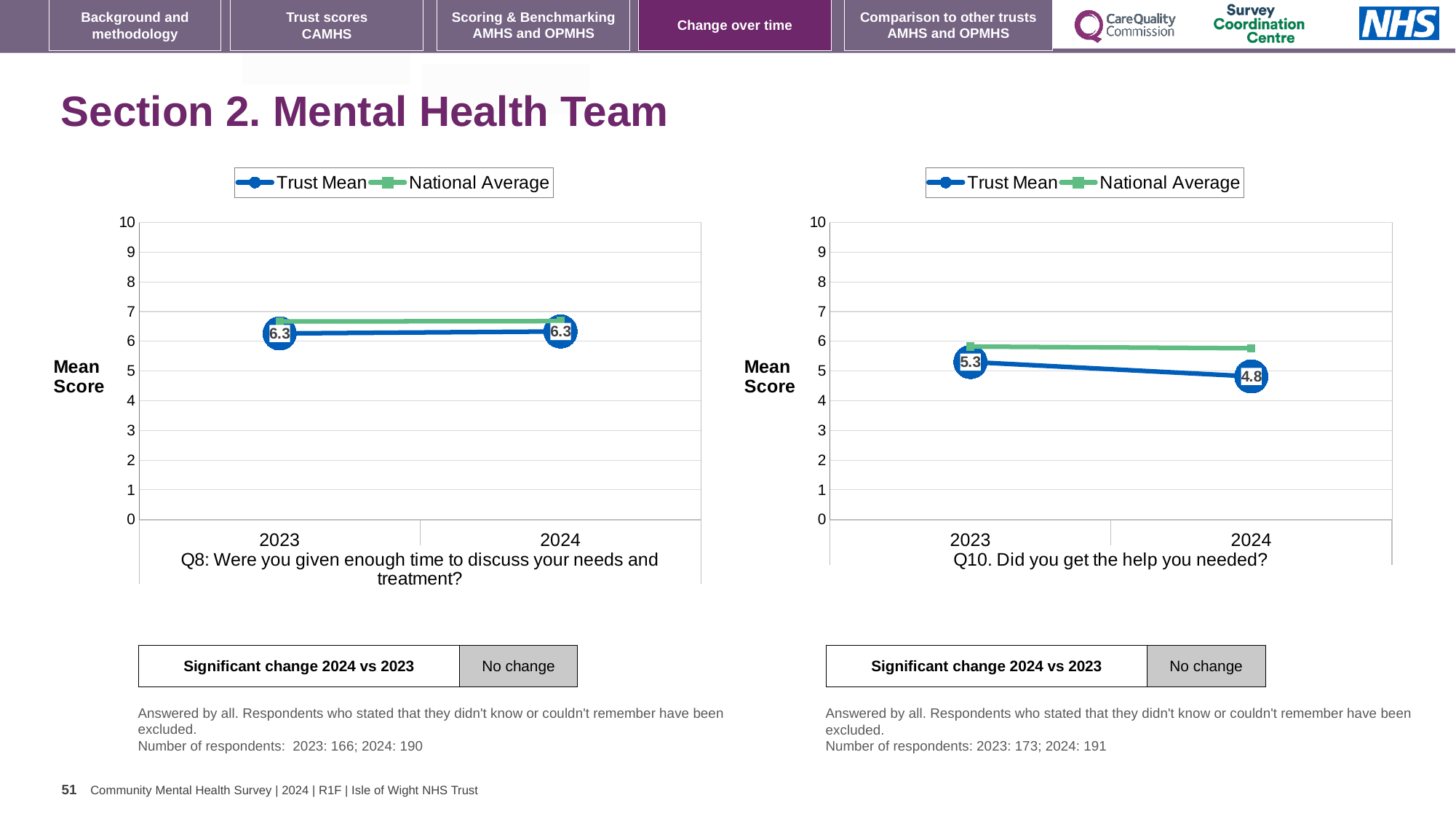
How many years are plotted on the x axis of the Q8 chart on the left? 2 In the Q10 chart on the right, is the National Average for 2023 greater or less than 5? greater What kind of chart is the Q8 chart on the left? line chart In the Q8 chart on the left, what is the Trust Mean score for 2023? 6.3 In the Q10 chart on the right, what is the Trust Mean score for 2024? 4.8 How many series does the legend of the Q10 chart on the right list? 2 In the Q10 chart on the right, by how much did the Trust Mean fall from 2023 to 2024? 0.5 In the Q8 chart on the left, is the National Average for 2024 greater or less than 6? greater In the Q10 chart on the right, what is the Trust Mean score for 2023? 5.3 In the Q8 chart on the left, what is the Trust Mean score for 2024? 6.3 In the Q10 chart on the right, which year has the higher Trust Mean, 2023 or 2024? 2023 In the Q10 chart on the right, does the Trust Mean rise or fall from 2023 to 2024? fall